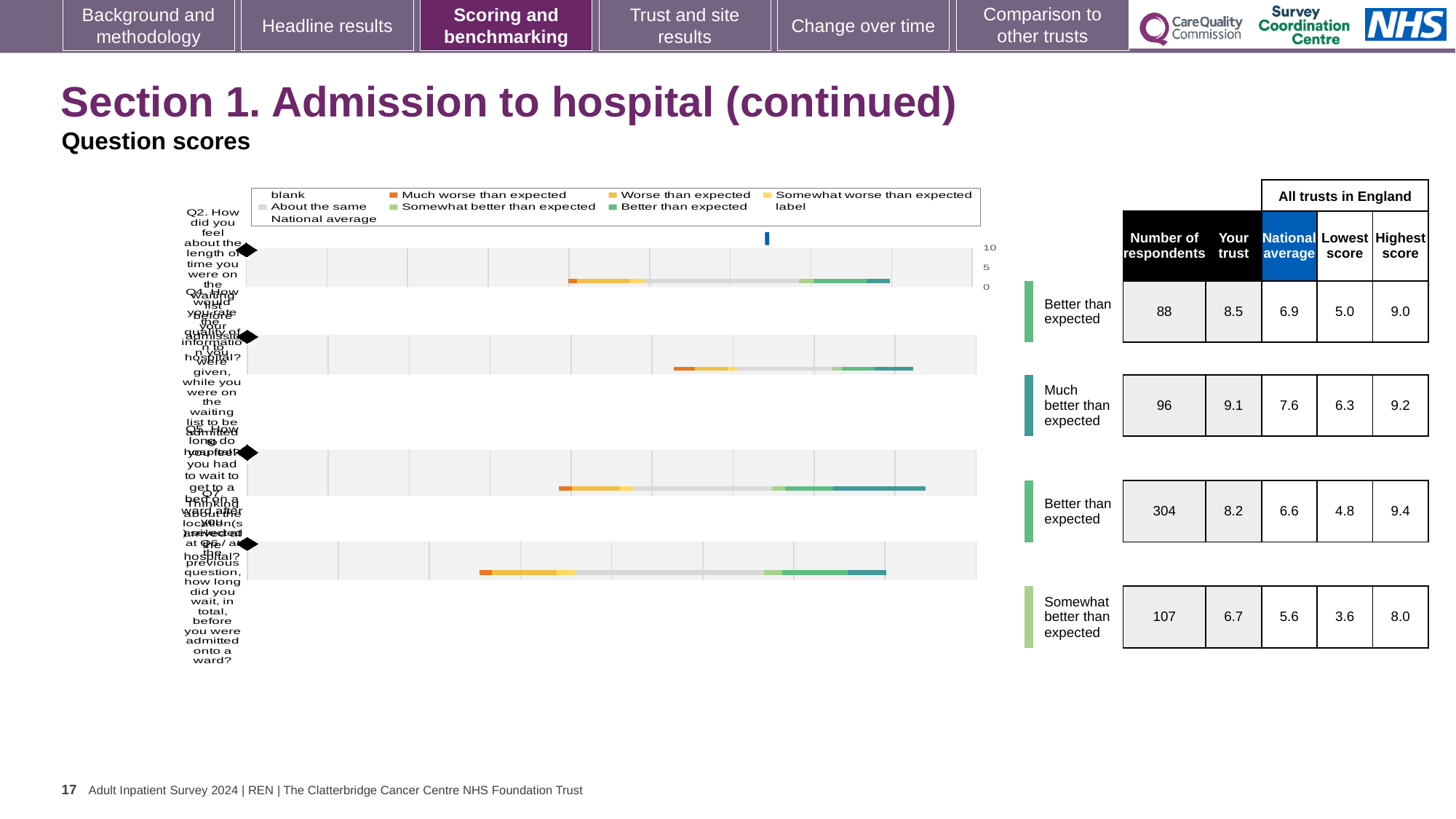
What is the highest value shown on the chart's axis? 10 In the table to the right of the chart, what is the national average for the third row (Better than expected, 304 respondents)? 6.6 In the table to the right of the chart, what is the highest score for the fourth row (Somewhat better than expected)? 8.0 In the table to the right of the chart, what is the 'Your trust' score for the second row (Much better than expected)? 9.1 In the table to the right of the chart, what is the difference between 'Your trust' and the national average for the second row (Much better than expected)? 1.5 How many question rows (bars) does the chart show? 4 In the table to the right of the chart, is the 'Your trust' score for the first row (8.5) larger or smaller than the national average (6.9)? larger What kind of chart is shown on the slide? bar chart Which legend entry is shown in orange on the chart? Much worse than expected In the table to the right of the chart, which row has the largest number of respondents? Better than expected (304) In the table to the right of the chart, which row has the lowest 'Your trust' score? Somewhat better than expected (6.7) In the table to the right of the chart, what is the number of respondents for the first row (Better than expected)? 88